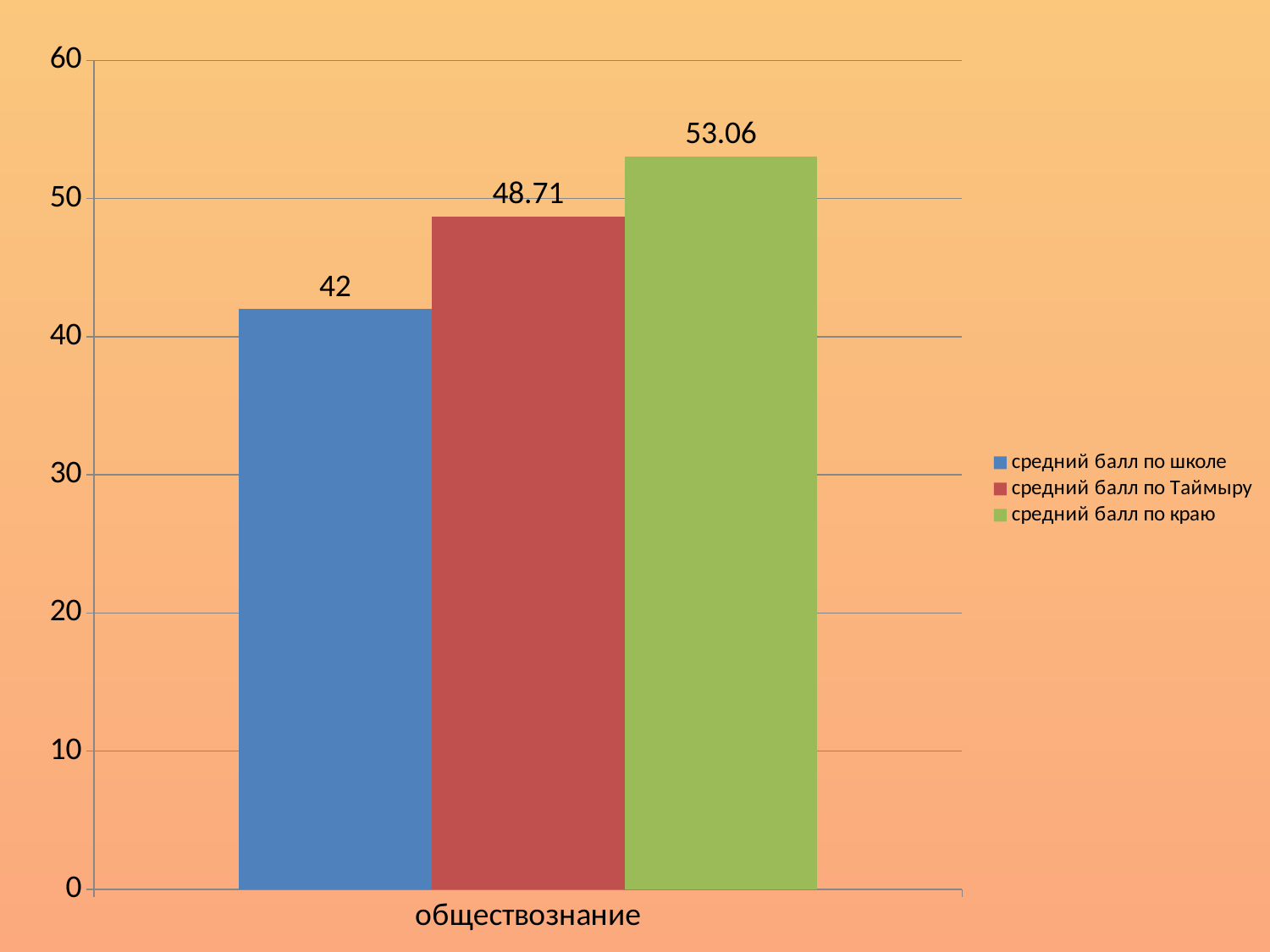
What kind of chart is shown on the slide? bar chart How many series does the legend list? 3 What is the difference between 'средний балл по краю' and 'средний балл по школе'? 11.06 What is the value for 'средний балл по краю' for обществознание? 53.06 What is the category label shown on the x axis? обществознание Which series has the lowest value for обществознание? средний балл по школе Which series has the highest value for обществознание? средний балл по краю What is the value for 'средний балл по школе' for обществознание? 42 Which is larger: 'средний балл по Таймыру' or 'средний балл по краю'? средний балл по краю What is the difference between 'средний балл по Таймыру' and 'средний балл по школе'? 6.71 Is the value for 'средний балл по школе' greater or less than 40? greater What is the value for 'средний балл по Таймыру' for обществознание? 48.71